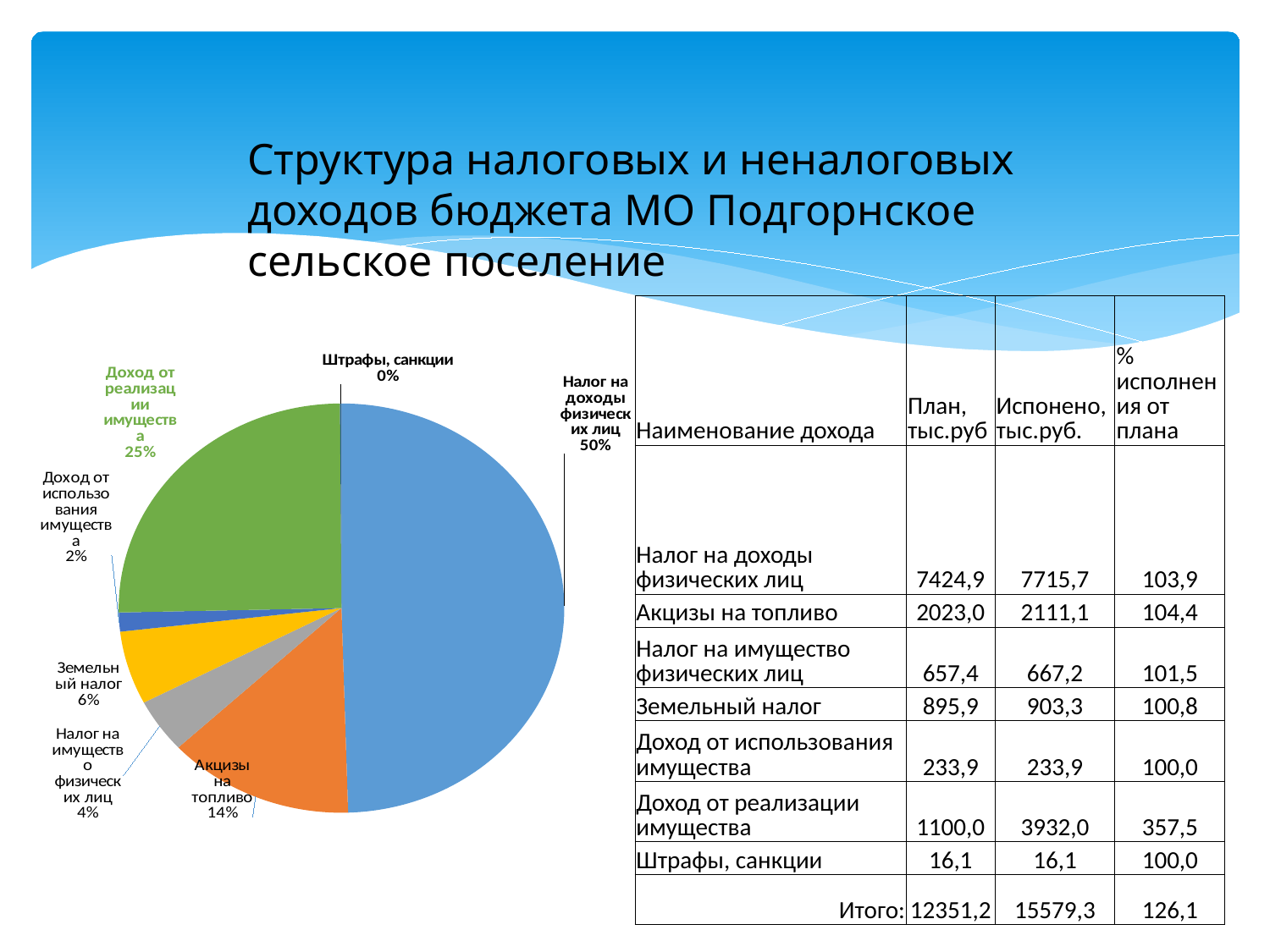
Which is larger in the pie chart: "Акцизы на топливо" or "Земельный налог"? Акцизы на топливо How many categories are shown in the pie chart? 7 What share of the pie does "Налог на имущество физических лиц" have? 4% What kind of chart is shown on the slide? pie chart What is the difference in percentage points between "Налог на доходы физических лиц" and "Доход от реализации имущества" in the pie chart? 25% What share of the pie does "Налог на доходы физических лиц" have? 50% Which category has the smallest slice of the pie? Штрафы, санкции What share of the pie does "Акцизы на топливо" have? 14% Which category has the largest slice of the pie? Налог на доходы физических лиц